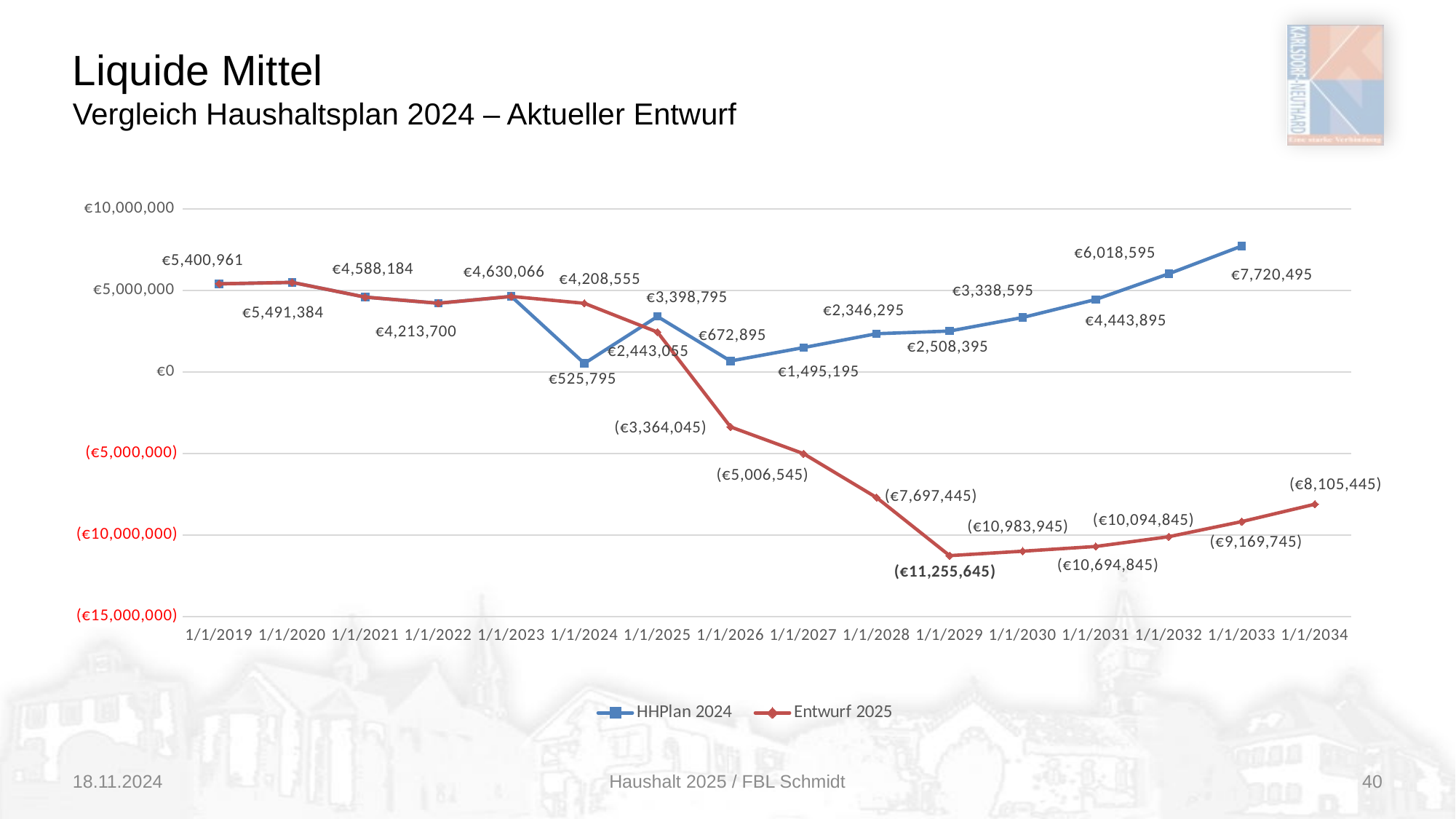
What kind of chart is shown on the slide? line chart How many series does the legend list? 2 What is the value of Entwurf 2025 at 1/1/2034? (€8,105,445) At which date does Entwurf 2025 reach its lowest value? 1/1/2029 By how much does HHPlan 2024 increase from 1/1/2032 to 1/1/2033? €1,701,900 What is the value of Entwurf 2025 at 1/1/2029? (€11,255,645) How many dates are shown on the x axis? 16 What is the value of HHPlan 2024 at 1/1/2024? €525,795 At 1/1/2026, which series has the higher value, HHPlan 2024 or Entwurf 2025? HHPlan 2024 What is the value of HHPlan 2024 at 1/1/2033? €7,720,495